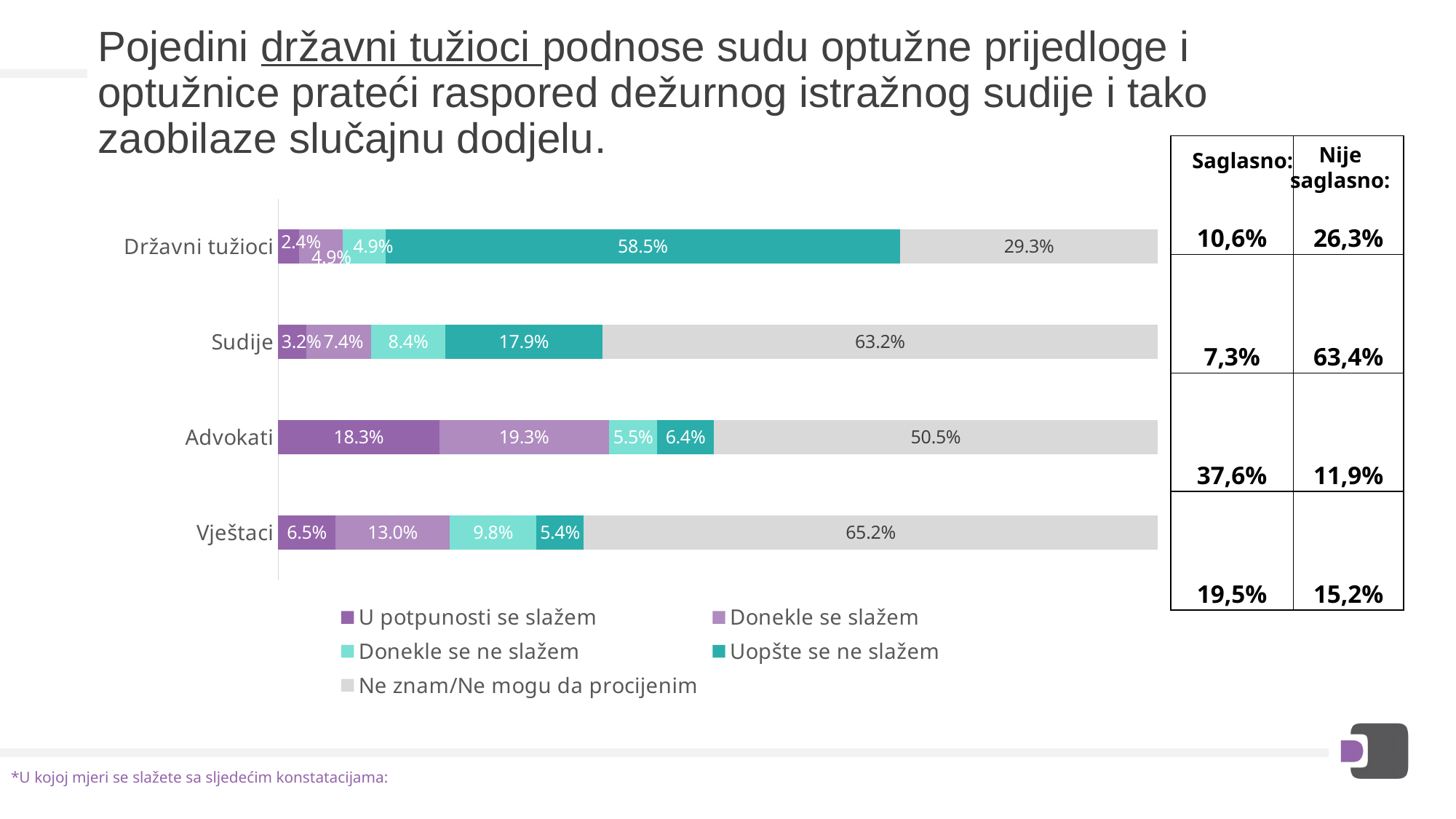
What is the difference between the 'Uopšte se ne slažem' values for Državni tužioci and Sudije? 40.6% What is the value of 'Uopšte se ne slažem' for Državni tužioci? 58.5% What is the value of 'U potpunosti se slažem' for Advokati? 18.3% How many series does the chart legend list? 5 What kind of chart is shown on the slide? Stacked bar chart How many categories are plotted on the chart? 4 What is the value of 'Ne znam/Ne mogu da procijenim' for Sudije? 63.2% Which is larger: the 'Donekle se slažem' value for Advokati or for Vještaci? Advokati Which category has the lowest value for 'Ne znam/Ne mogu da procijenim'? Državni tužioci Which category has the highest value for 'U potpunosti se slažem'? Advokati Which legend entry is shown in the light grey colour? Ne znam/Ne mogu da procijenim What is the value of 'Donekle se ne slažem' for Vještaci? 9.8%